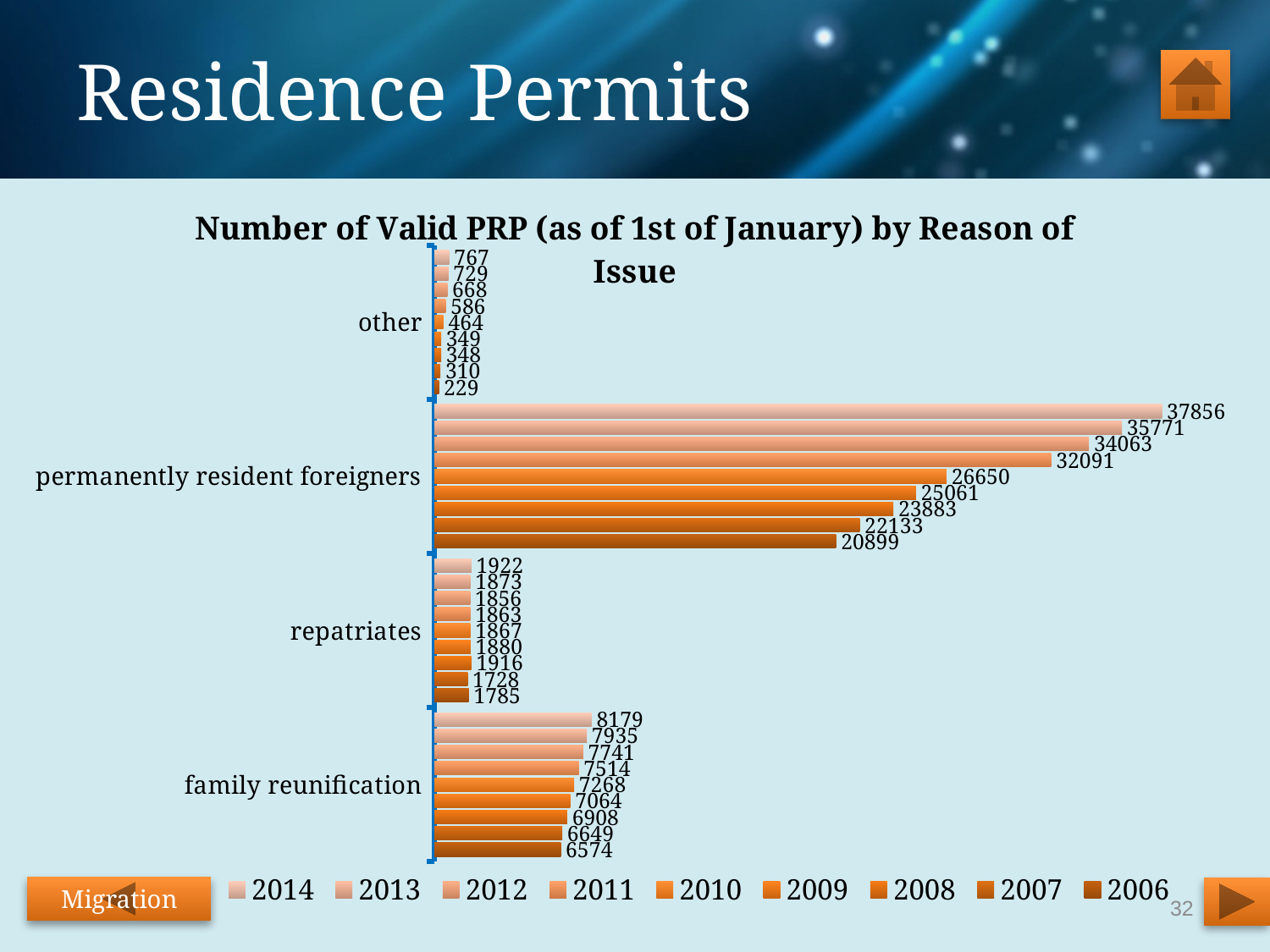
Which category has the highest number of valid PRP in 2014? permanently resident foreigners What is the number of valid PRP for family reunification in 2006? 6574 What is the number of valid PRP for the 'other' category in 2011? 586 Which category has the lowest number of valid PRP in 2006? other What is the number of valid PRP for permanently resident foreigners in 2014? 37856 Which is larger: the 2014 value for family reunification or the 2014 value for repatriates? family reunification How many reason-of-issue categories are shown on the chart? 4 What is the number of valid PRP for repatriates in 2010? 1867 What kind of chart is shown on the slide? bar chart What is the difference between the 2014 and 2006 values for permanently resident foreigners? 16957 What is the title of the chart? Number of Valid PRP (as of 1st of January) by Reason of Issue How many series does the legend list? 9